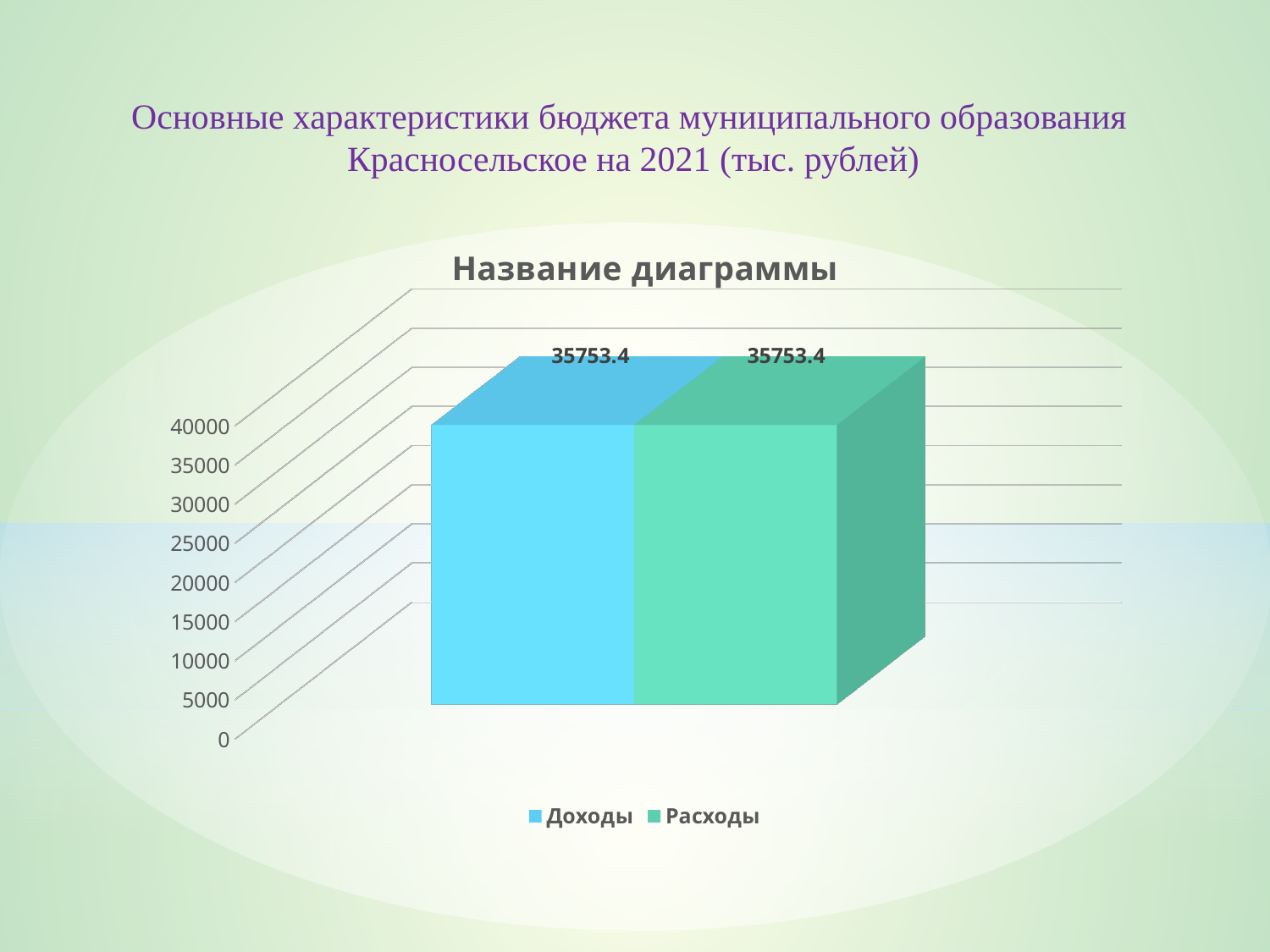
What is the title of the chart? Название диаграммы What kind of chart is shown on the slide? bar chart How many series does the legend list? 2 What is the value for Расходы? 35753.4 What is the difference between the values for Доходы and Расходы? 0 Which legend entry is shown in blue? Доходы What is the total of the values for Доходы and Расходы? 71506.8 What is the value for Доходы? 35753.4 Is the value for Расходы greater or less than 40000? less Is the value for Доходы greater or less than 30000? greater